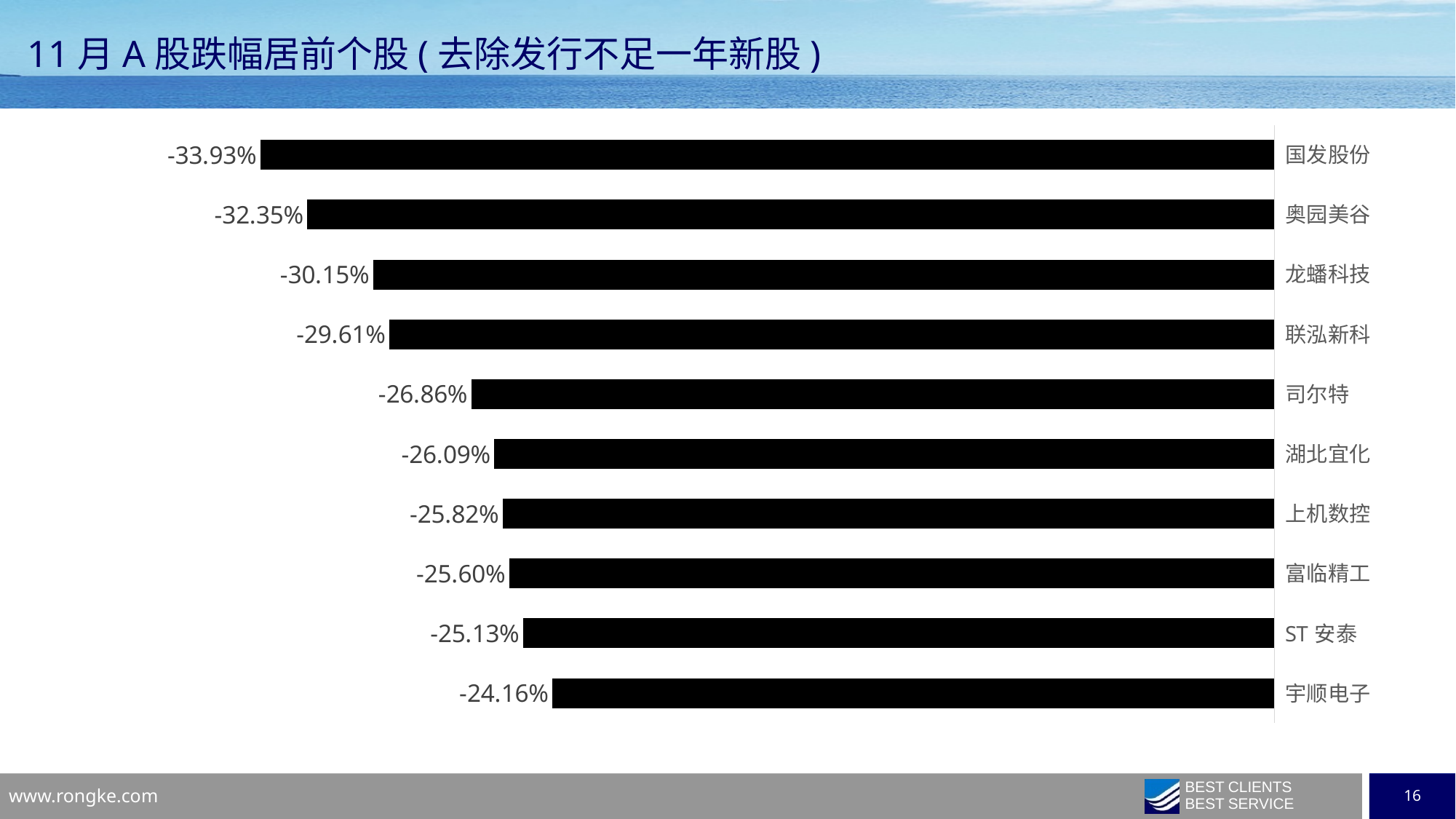
What is the value shown for 国发股份? -33.93% Which stock fell more in November, 湖北宜化 or 上机数控? 湖北宜化 What is the value shown for ST 安泰? -25.13% What is the difference in percentage points between the values for 奥园美谷 and 龙蟠科技? 2.20 percentage points Which stock has the largest decline (the lowest value) on the chart? 国发股份 What kind of chart is shown on the slide? Bar chart What is the title of the slide? 11 月 A 股跌幅居前个股 ( 去除发行不足一年新股 ) What is the value shown for 司尔特? -26.86% How many stocks are shown on the chart? 10 What is the value shown for 富临精工? -25.60% What is the difference in percentage points between the values for 国发股份 and 宇顺电子? 9.77 percentage points Which stock has the smallest decline (the highest value) on the chart? 宇顺电子